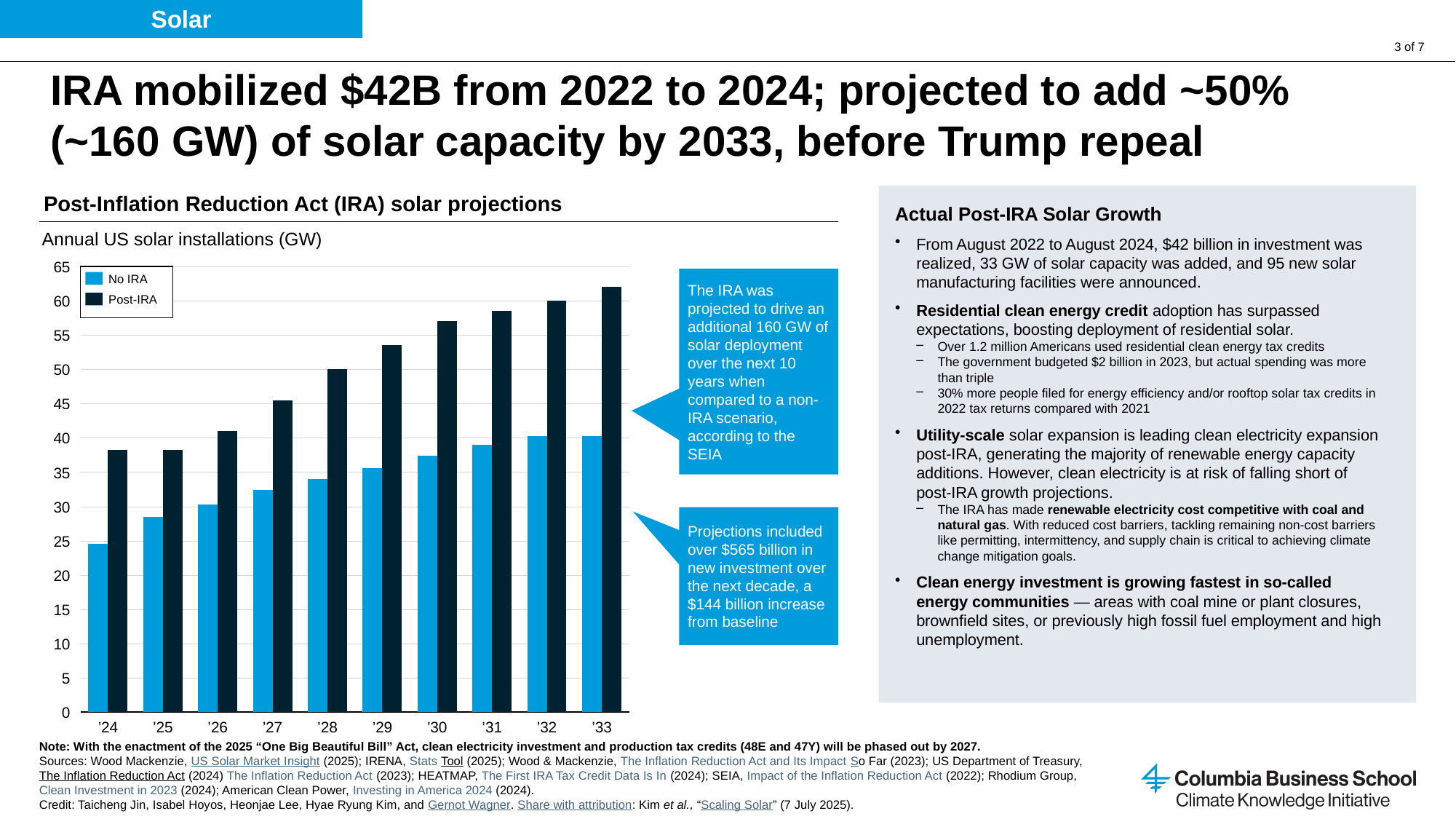
What kind of chart is shown on the slide? bar chart Which year has the lowest No IRA value? '24 Which year has the highest Post-IRA value? '33 In '29, which series has the larger value, No IRA or Post-IRA? Post-IRA What are the two series named in the chart legend? No IRA and Post-IRA Is the Post-IRA value for '33 greater or less than 60? greater What is the unit of the values plotted on the chart? GW Is the Post-IRA value for '30 greater or less than 55? greater Do the Post-IRA values rise or fall from '24 to '33? rise How many series does the chart legend list? 2 How many years are shown along the x axis of the chart? 10